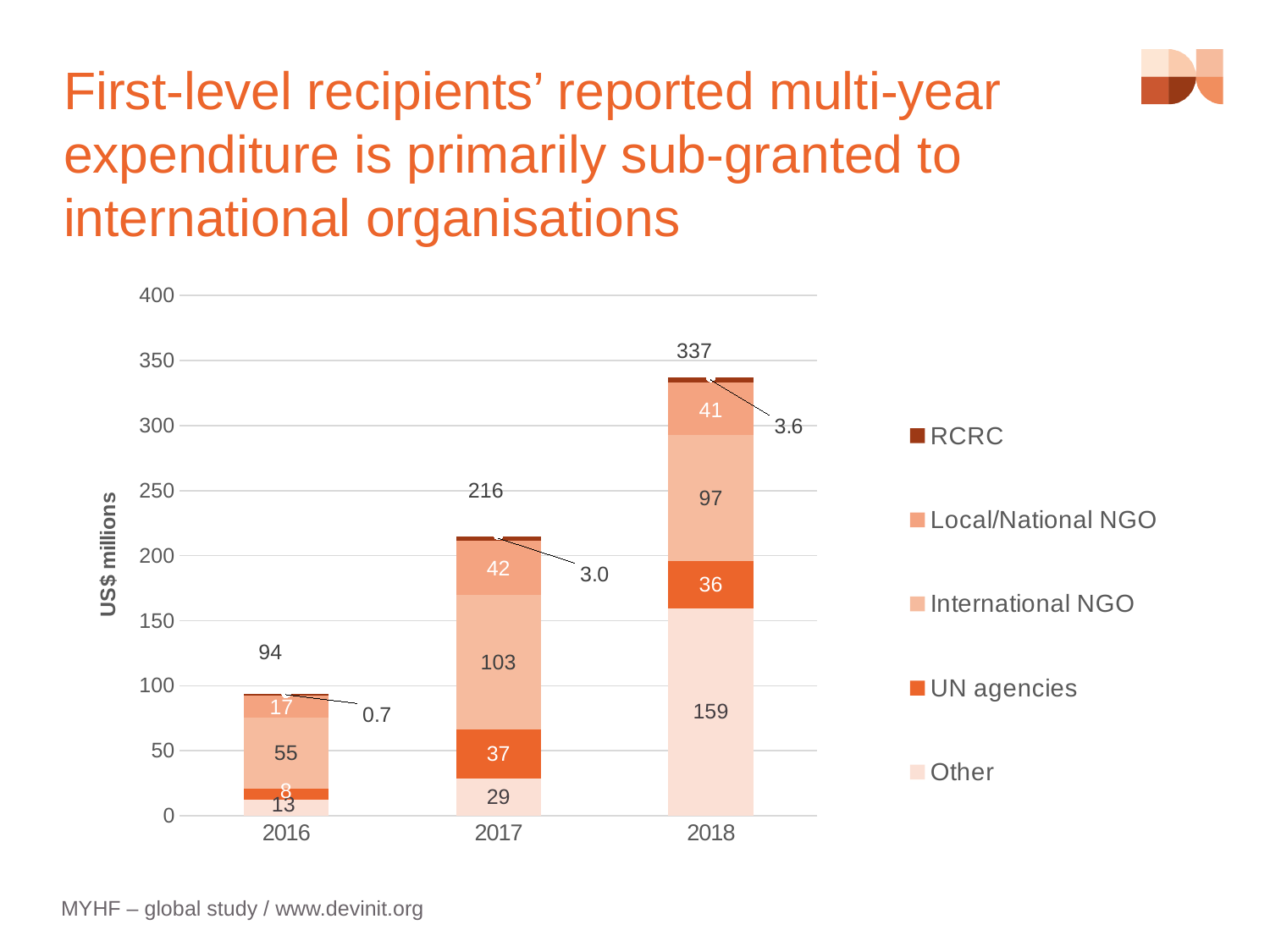
Which year has the highest total expenditure? 2018 How many years are shown on the x axis? 3 What is the value for RCRC in 2016? 0.7 What is the total reported expenditure for 2018? 337 Do the total values rise or fall from 2016 to 2018? Rise What is the value for International NGO in 2017? 103 What is the value for Other in 2018? 159 What is the difference between the total for 2018 and the total for 2017? 121 Which year has the lowest total expenditure? 2016 How many series does the legend list? 5 Which is larger in 2018: the value for International NGO or the value for Local/National NGO? International NGO What type of chart is shown on the slide? Stacked bar chart